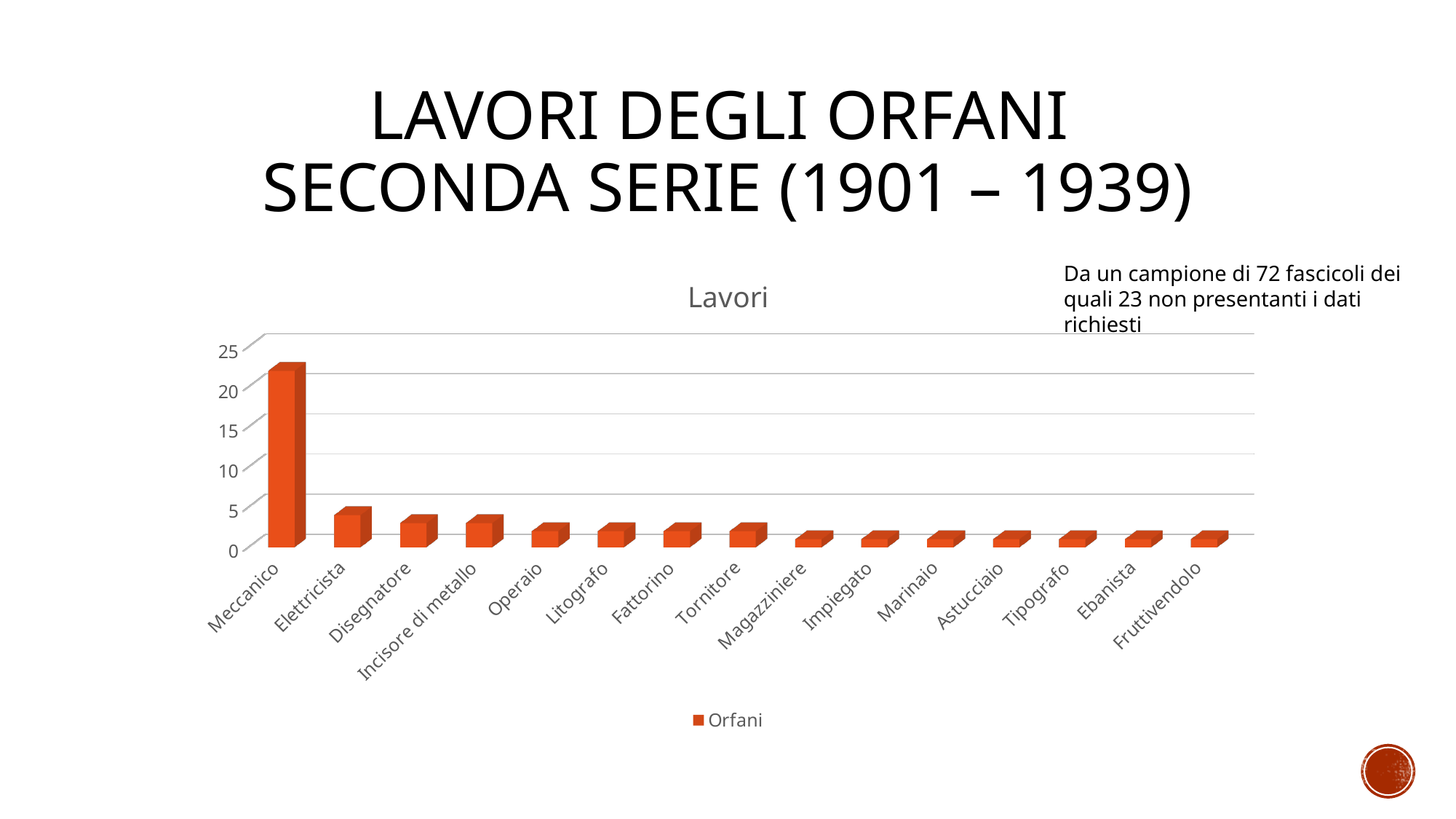
Which category has the highest value? Meccanico What is the title of the chart? Lavori Which is larger, the value for Meccanico or the value for Elettricista? Meccanico Is the value for Elettricista greater or less than 5? less How many categories are shown on the x axis of the chart? 15 What is the name of the series shown in the legend? Orfani Do the values generally rise or fall moving from left to right along the x axis? fall What kind of chart is shown on the slide? bar chart Which is larger, the value for Elettricista or the value for Magazziniere? Elettricista Is the value for Fruttivendolo greater or less than 5? less Is the value for Meccanico greater or less than 15? greater How many series does the legend list? 1